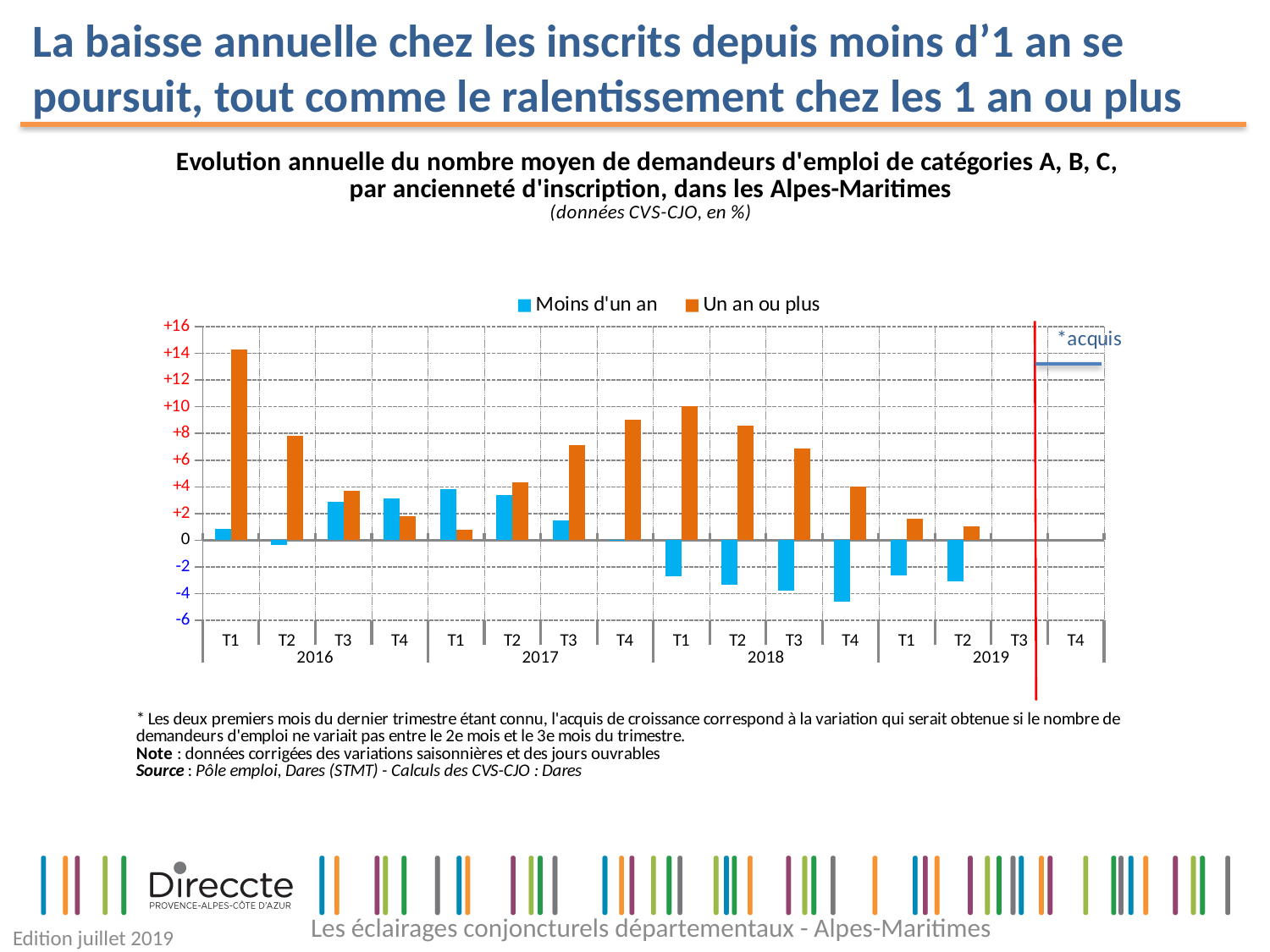
In which quarter is the value for 'Moins d'un an' the lowest? T4 2018 Which is larger in T1 2017: the value for 'Moins d'un an' or the value for 'Un an ou plus'? Moins d'un an In which quarter is the value for 'Un an ou plus' the highest? T1 2016 Does the value for 'Un an ou plus' rise or fall from T1 2018 to T2 2019? fall Is the value for 'Moins d'un an' in T4 2018 greater or less than -4? less Which colour represents the series 'Un an ou plus'? orange What are the two series named in the legend? Moins d'un an; Un an ou plus Is the value for 'Un an ou plus' in T1 2018 greater or less than +8? greater What kind of chart is shown on the slide? bar chart Is the value for 'Un an ou plus' in T1 2016 greater or less than +12? greater How many years are labelled on the x axis? 4 How many series does the legend list? 2